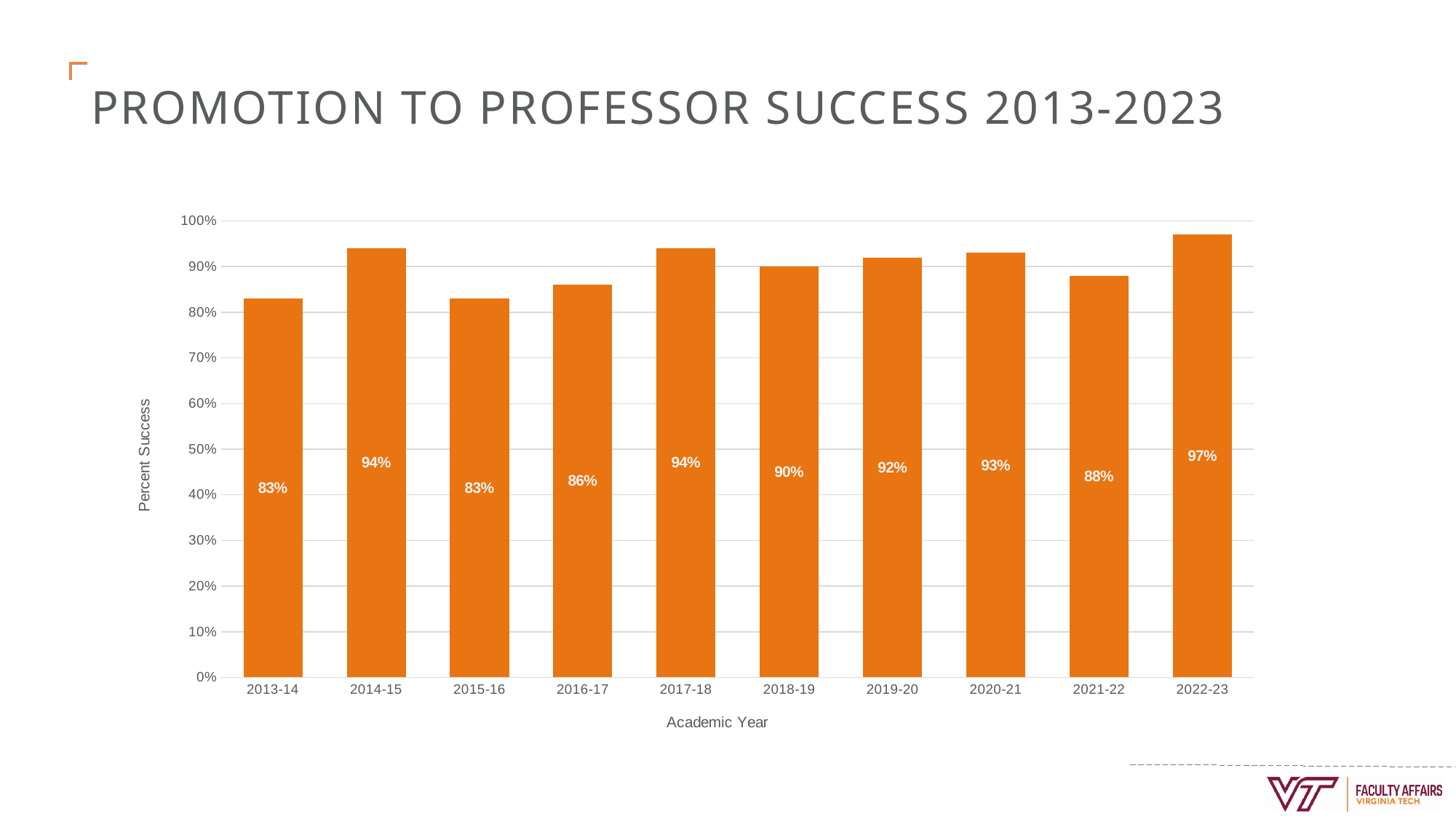
Which has a higher percent success, 2016-17 or 2019-20? 2019-20 What kind of chart is shown on the slide? Bar chart What is the percent success for 2022-23? 97% What is the lowest percent success shown on the chart? 83% What is the label on the x axis of the chart? Academic Year How many academic years are shown on the chart? 10 Which academic year has the highest percent success? 2022-23 What is the percent success for 2013-14? 83% Is the value for 2020-21 greater or less than 90%? greater What is the difference in percent success between 2022-23 and 2021-22? 9% What is the percent success for 2018-19? 90% What is the title of the slide? PROMOTION TO PROFESSOR SUCCESS 2013-2023